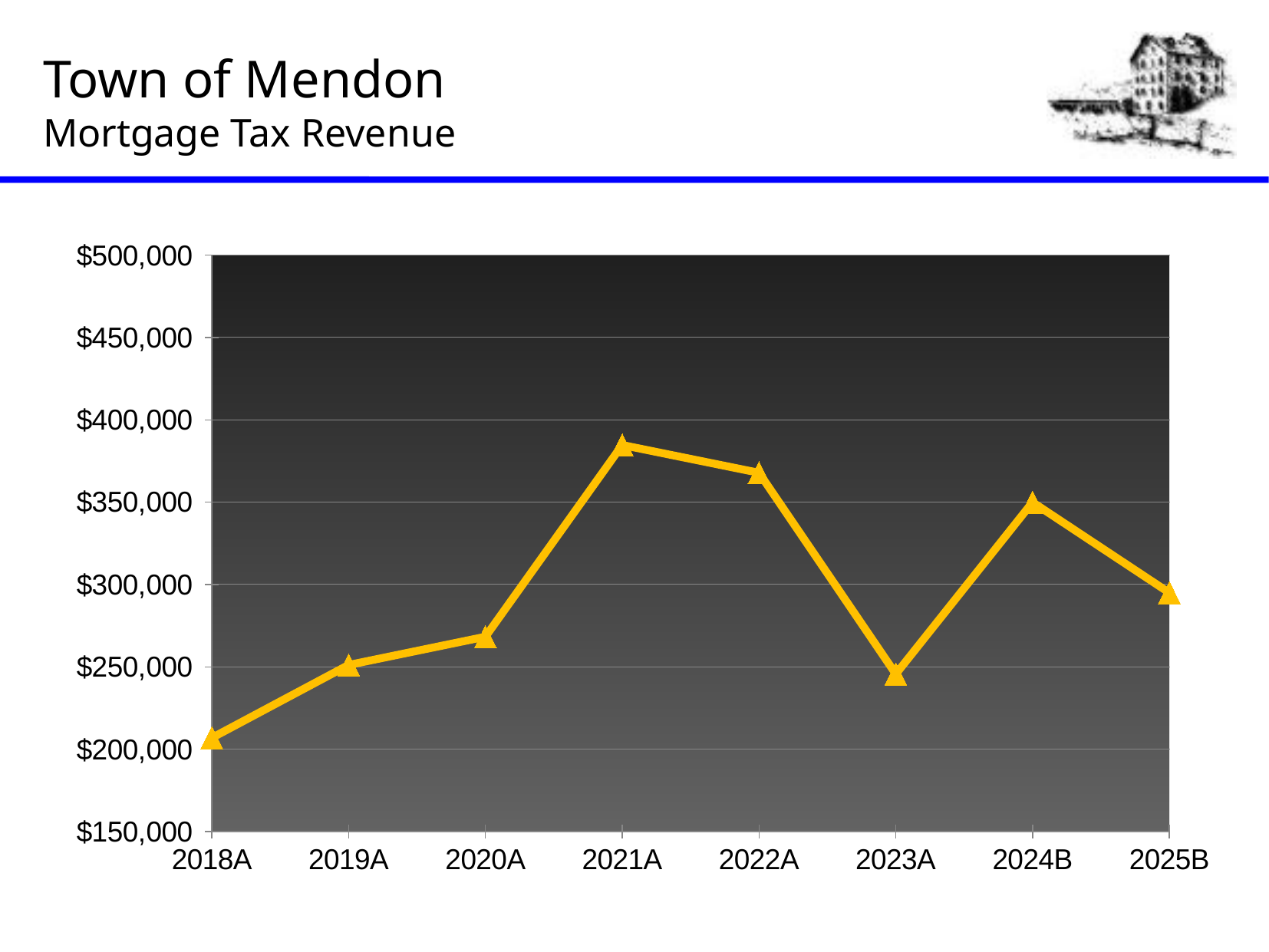
Is the value for 2023A greater or less than $300,000? less How many years are plotted along the x axis? 8 Is the value for 2021A greater or less than $350,000? greater Is the value for 2025B greater or less than $250,000? greater Which year has the highest mortgage tax revenue? 2021A Which year has the lowest mortgage tax revenue? 2018A Which year has the larger value, 2024B or 2025B? 2024B Do the values rise or fall from 2018A to 2021A? rise What kind of chart is shown on the slide? line chart What is the subtitle of the slide describing the chart's data? Mortgage Tax Revenue